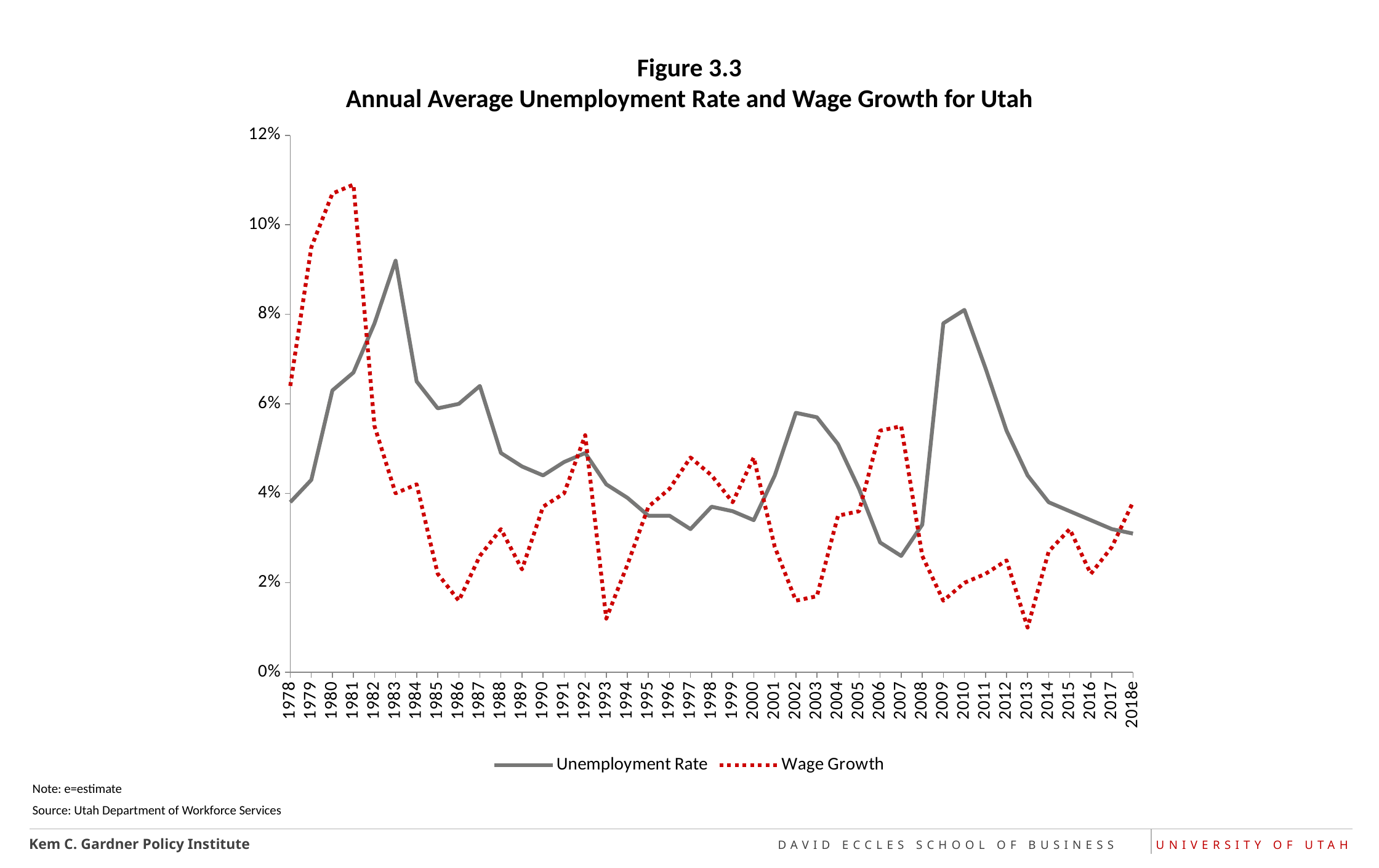
In 1981, which is larger: the Unemployment Rate or Wage Growth? Wage Growth Is Wage Growth in 1981 greater or less than 10%? greater In 2009, which is larger: the Unemployment Rate or Wage Growth? Unemployment Rate How many series does the legend list? 2 What kind of chart is shown on the slide? Line chart In which year does the Unemployment Rate reach its highest value? 1983 In which year does Wage Growth reach its highest value? 1981 Which two series are listed in the legend? Unemployment Rate and Wage Growth How many years are plotted along the x axis, from 1978 to 2018e? 41 Is Wage Growth in 1993 greater or less than 2%? less Is the Unemployment Rate in 1983 greater or less than 8%? greater Does the Unemployment Rate rise or fall from 2010 to 2018e? Fall